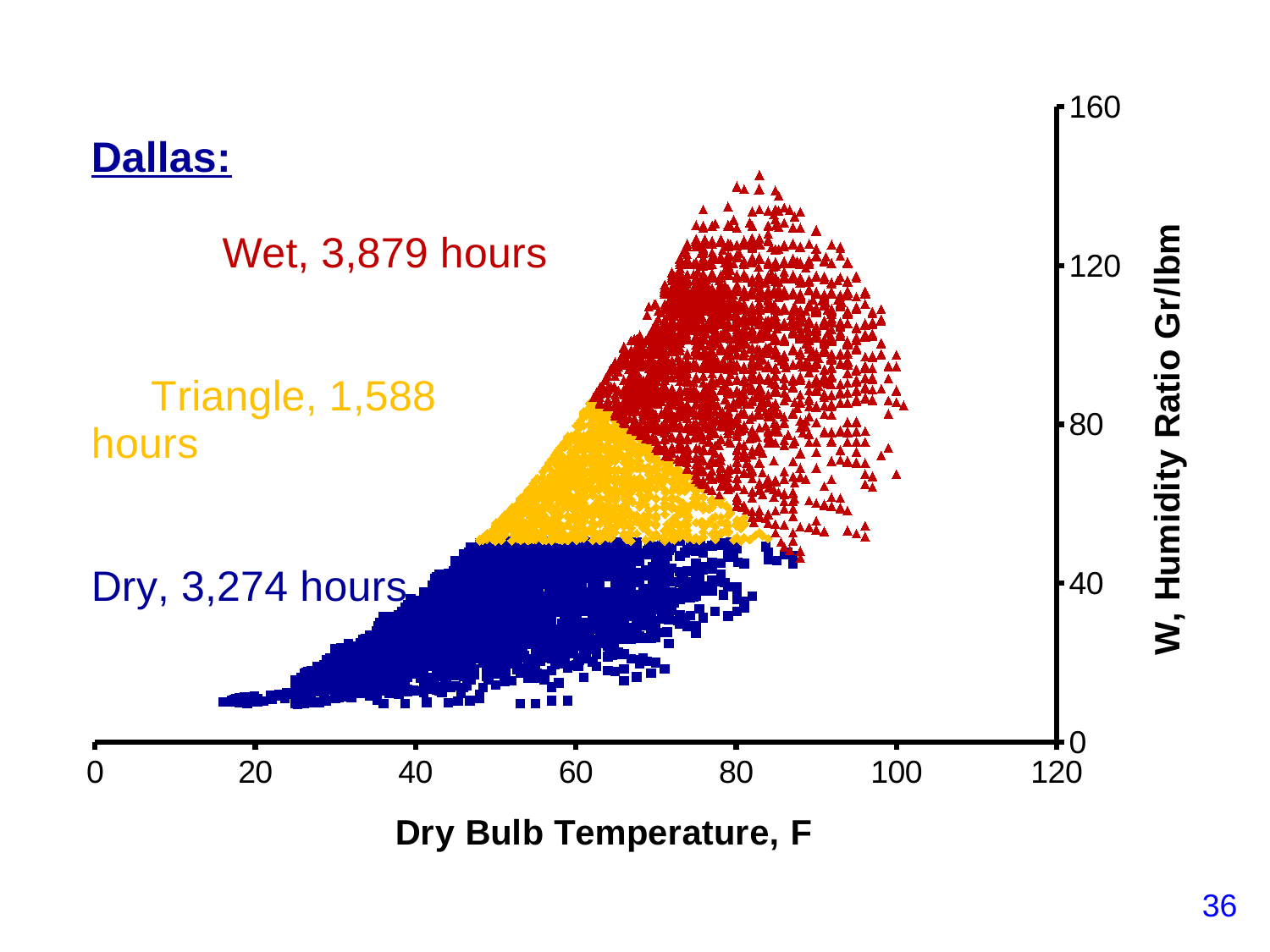
How many groups of points are plotted on the chart? 3 Which group has the fewest hours? Triangle What is the label of the horizontal axis? Dry Bulb Temperature, F Which has more hours, Dry or Triangle? Dry How many hours are labelled for the Wet group? 3,879 hours Is the highest humidity ratio reached by the Wet (red) points greater or less than 160? less How many hours are labelled for the Dry group? 3,274 hours What is the total number of hours across the Wet, Triangle and Dry groups? 8,741 hours How many hours are labelled for the Triangle group? 1,588 hours What kind of chart is shown on the slide? scatter chart Which group has the most hours? Wet What is the difference in hours between the Wet and Dry groups? 605 hours